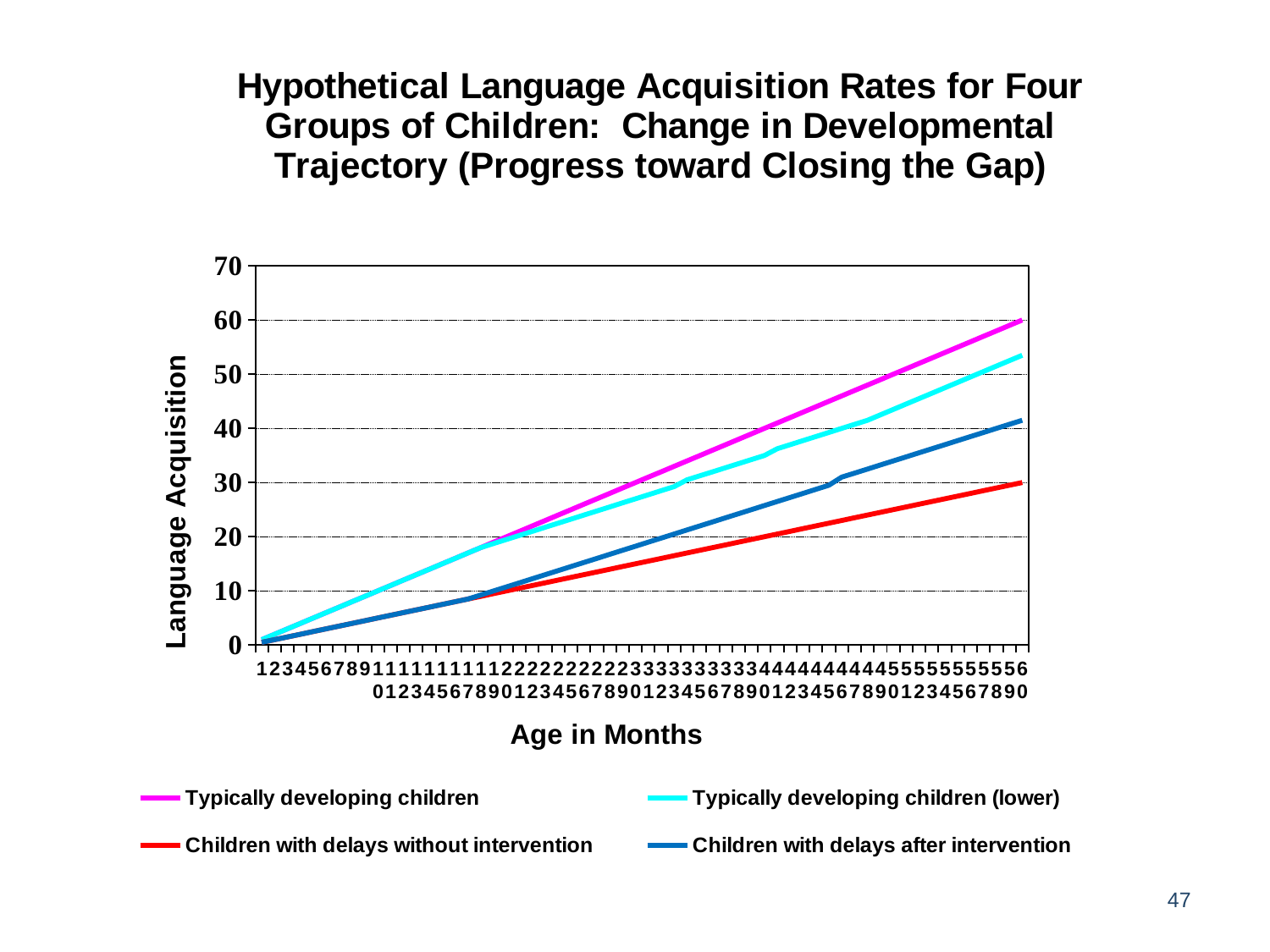
Do the values for Children with delays after intervention rise or fall as age in months increases? rise Which series has the highest value at 60 months? Typically developing children What is the label of the x axis? Age in Months How many series does the legend list? 4 What is the label of the y axis? Language Acquisition Is the value for Children with delays without intervention at 40 months greater or less than 30? less Is the value for Typically developing children (lower) at 60 months greater or less than 50? greater Is the value for Children with delays after intervention at 60 months greater or less than 40? greater Which series has the lowest value at 60 months? Children with delays without intervention What is the value for Typically developing children at 60 months? 60 At 60 months, which is larger: Typically developing children (lower) or Children with delays after intervention? Typically developing children (lower) What kind of chart is shown on the slide? line chart